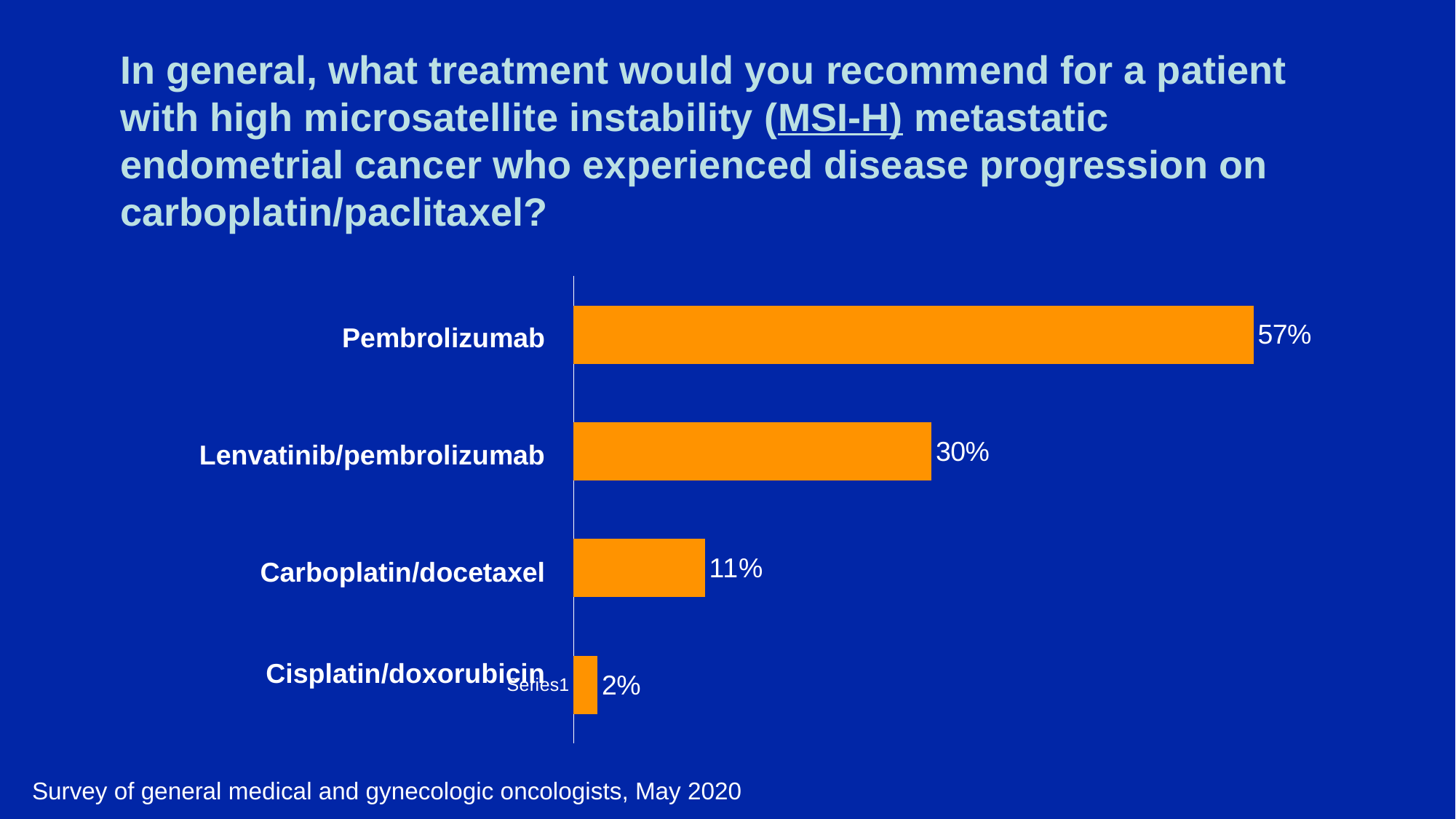
Which treatment was recommended by the highest percentage of respondents? Pembrolizumab What is the difference in percentage points between pembrolizumab and lenvatinib/pembrolizumab? 27 What percentage of respondents recommended carboplatin/docetaxel? 11% What type of chart is shown on the slide? Bar chart What percentage of respondents recommended cisplatin/doxorubicin? 2% What percentage of respondents recommended pembrolizumab? 57% Which treatment was recommended by the lowest percentage of respondents? Cisplatin/doxorubicin How many treatment options are shown in the chart? 4 What colour are the bars in the chart? Orange What percentage of respondents recommended lenvatinib/pembrolizumab? 30% Which was recommended by more respondents, lenvatinib/pembrolizumab or carboplatin/docetaxel? Lenvatinib/pembrolizumab What is the difference in percentage points between carboplatin/docetaxel and cisplatin/doxorubicin? 9